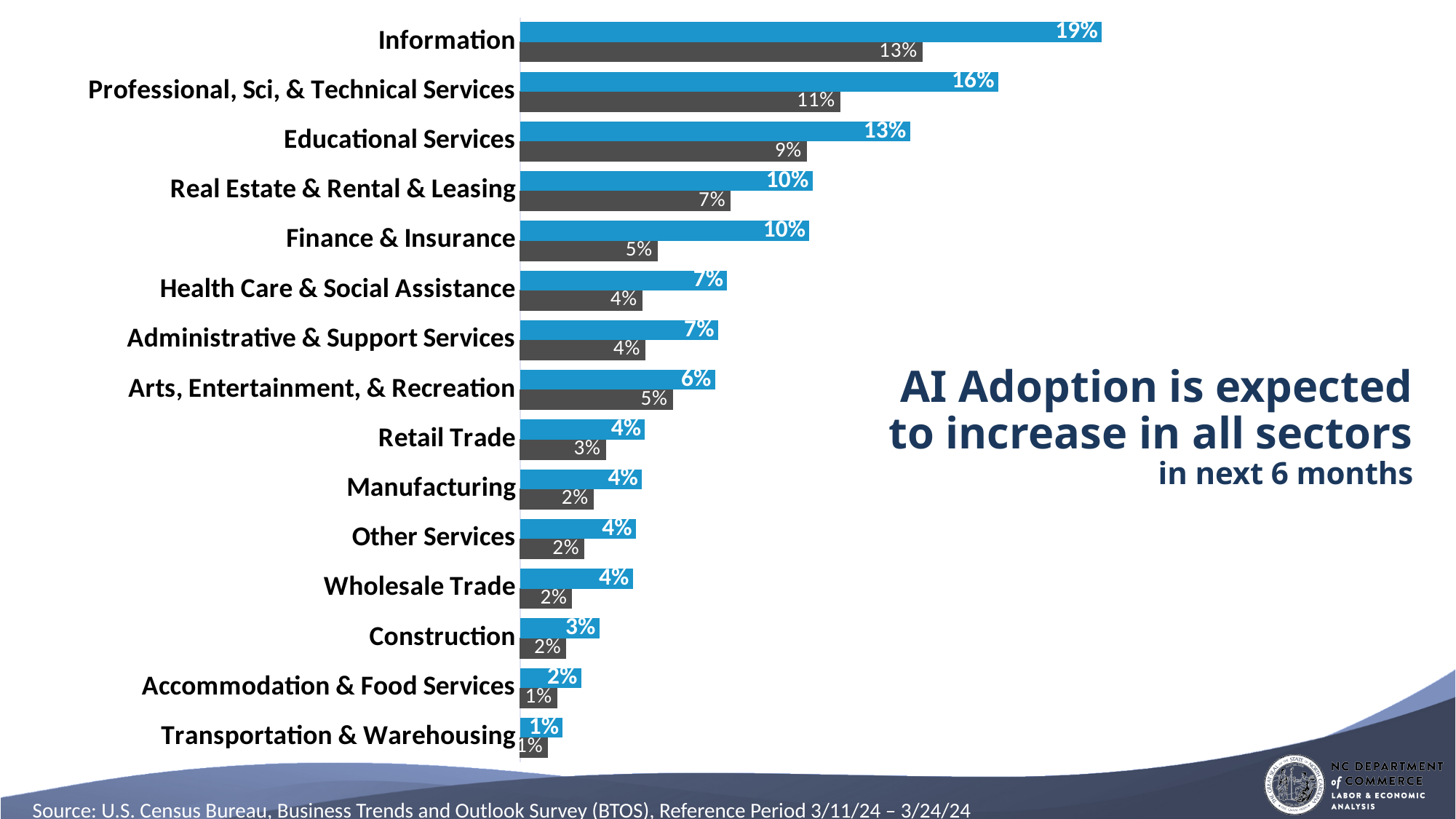
What is the difference between the blue bar values for Professional, Sci, & Technical Services and Educational Services? 3% What is the value of the blue bar for Information? 19% How many sectors are shown on the chart? 15 Which is larger, the dark gray bar for Real Estate & Rental & Leasing or the dark gray bar for Health Care & Social Assistance? Real Estate & Rental & Leasing What is the title text shown next to the chart? AI Adoption is expected to increase in all sectors in next 6 months What is the value of the blue bar for Educational Services? 13% What type of chart is shown on the slide? Bar chart What is the value of the dark gray bar for Finance & Insurance? 5% What is the difference between the blue bar and the dark gray bar for Information? 6% Which sector has the lowest blue bar value? Transportation & Warehousing Which sector has the highest blue bar value? Information What is the value of the dark gray bar for Professional, Sci, & Technical Services? 11%